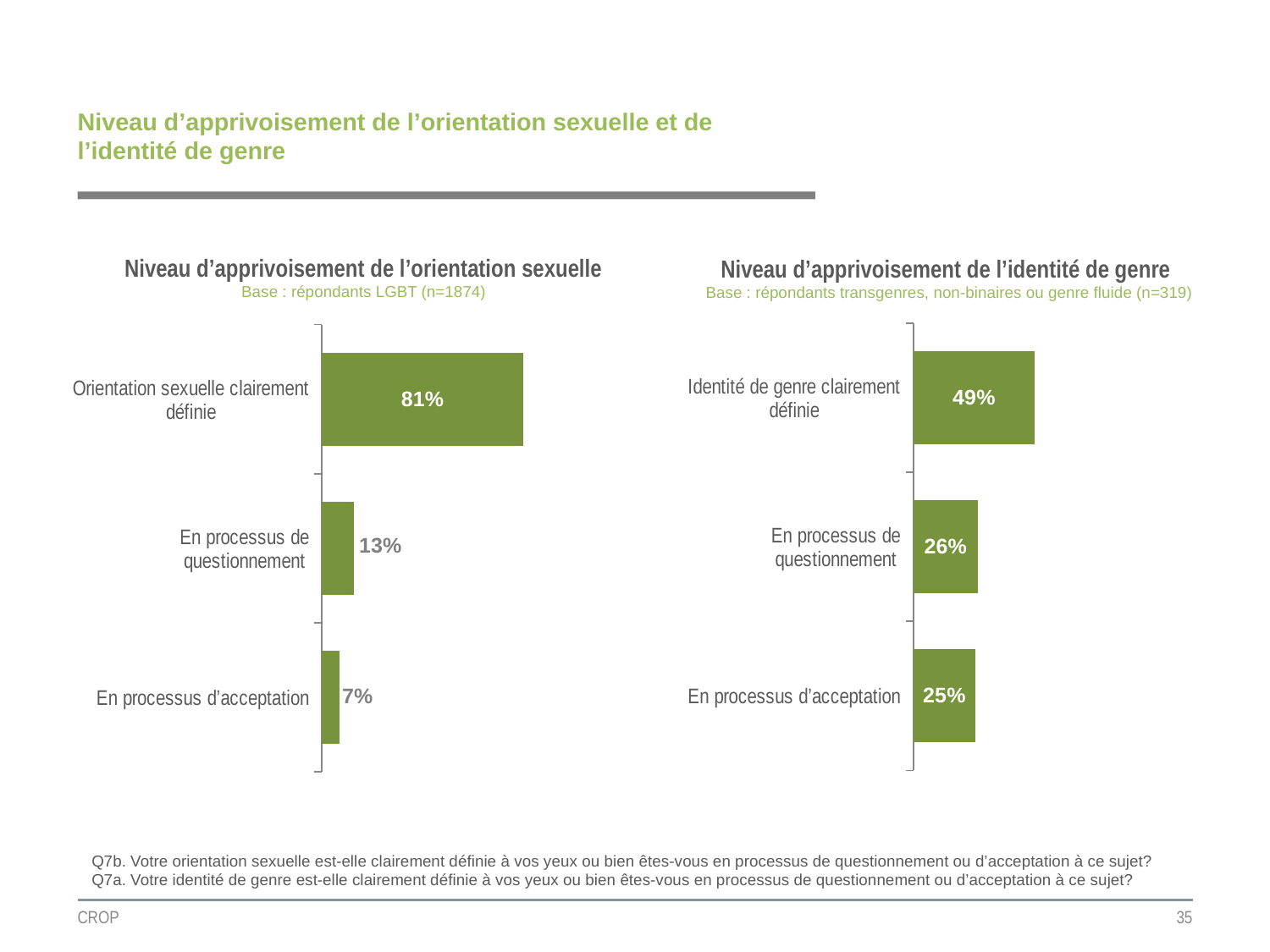
In the chart 'Niveau d'apprivoisement de l'identité de genre', which category has the highest value? Identité de genre clairement définie Which is larger: 'En processus de questionnement' in the left chart or 'En processus de questionnement' in the right chart? The right chart (26%) In the chart 'Niveau d'apprivoisement de l'orientation sexuelle', what is the value for 'Orientation sexuelle clairement définie'? 81% In the chart 'Niveau d'apprivoisement de l'orientation sexuelle', which category has the lowest value? En processus d'acceptation In the chart 'Niveau d'apprivoisement de l'identité de genre', what is the value for 'En processus de questionnement'? 26% What is the base (n) stated under the chart 'Niveau d'apprivoisement de l'identité de genre'? n=319 In the chart 'Niveau d'apprivoisement de l'identité de genre', what is the difference between 'Identité de genre clairement définie' and 'En processus d'acceptation'? 24% How many categories does the chart 'Niveau d'apprivoisement de l'orientation sexuelle' show? 3 What is the base (n) stated under the chart 'Niveau d'apprivoisement de l'orientation sexuelle'? n=1874 In the chart 'Niveau d'apprivoisement de l'identité de genre', what is the value for 'En processus d'acceptation'? 25% What kind of chart is 'Niveau d'apprivoisement de l'identité de genre'? Bar chart In the chart 'Niveau d'apprivoisement de l'orientation sexuelle', what is the difference between 'Orientation sexuelle clairement définie' and 'En processus de questionnement'? 68%